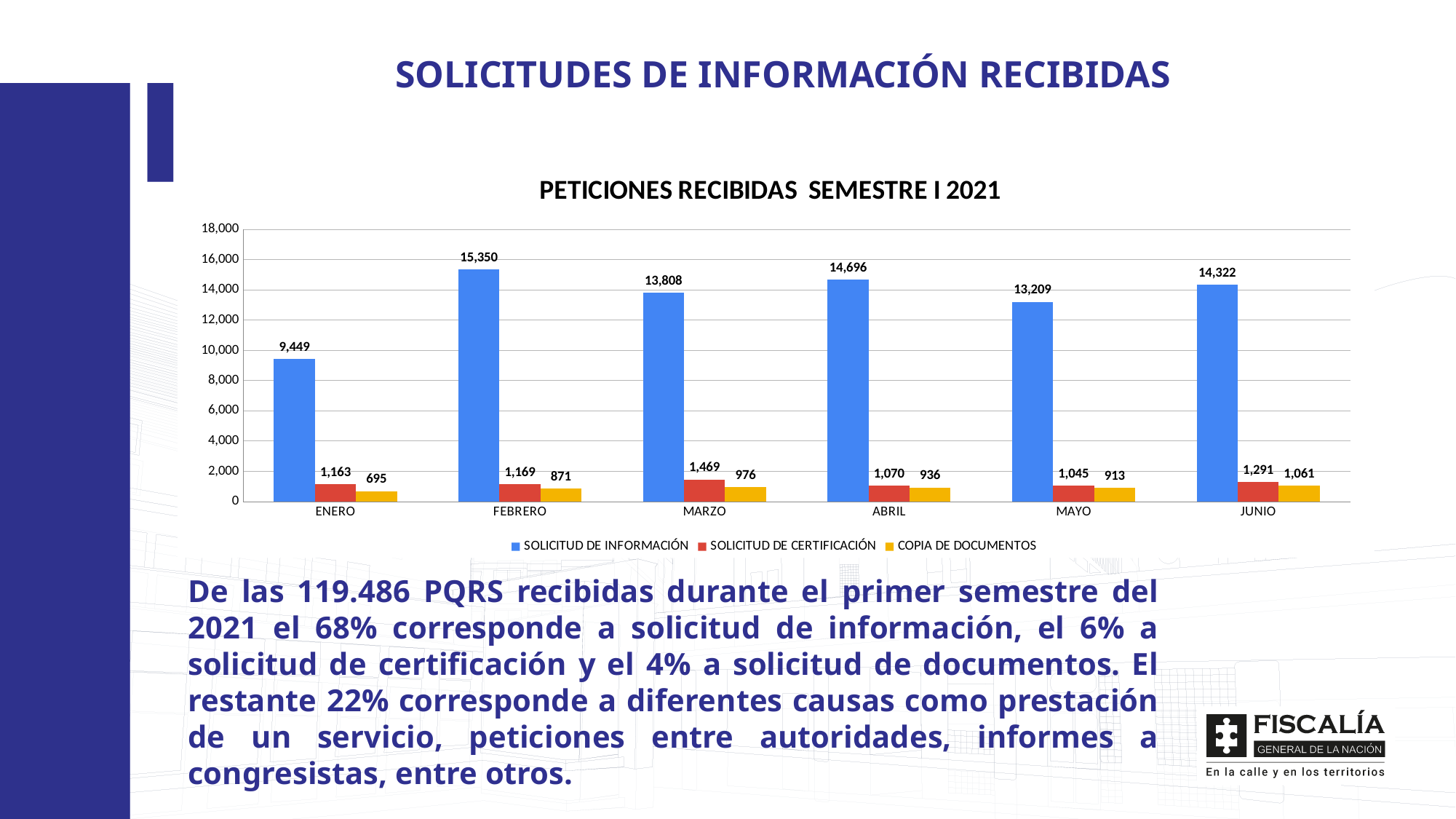
How many series does the legend list? 3 Which is larger, the SOLICITUD DE INFORMACIÓN value for ABRIL or for JUNIO? ABRIL What is the title of the chart? PETICIONES RECIBIDAS SEMESTRE I 2021 What is the value for SOLICITUD DE INFORMACIÓN in FEBRERO? 15,350 Which month has the highest value for SOLICITUD DE INFORMACIÓN? FEBRERO Which month has the lowest value for COPIA DE DOCUMENTOS? ENERO Is the value for SOLICITUD DE INFORMACIÓN in MAYO greater or less than 12,000? greater What is the value for SOLICITUD DE CERTIFICACIÓN in MARZO? 1,469 What is the difference between the SOLICITUD DE INFORMACIÓN values for FEBRERO and ENERO? 5,901 What is the value for COPIA DE DOCUMENTOS in JUNIO? 1,061 What kind of chart is shown on the slide? bar chart How many months are shown on the x axis? 6